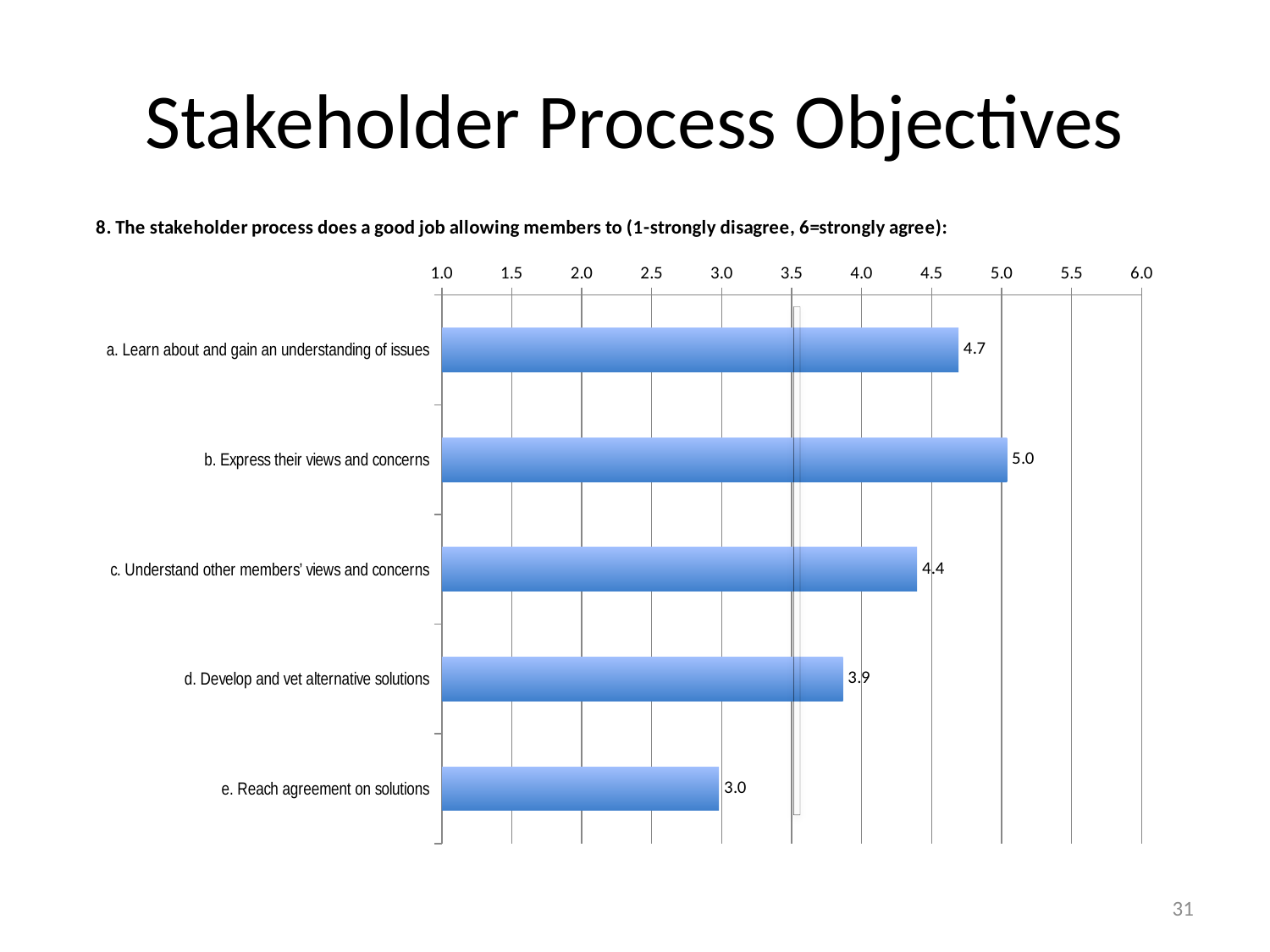
Is the value for "d. Develop and vet alternative solutions" greater or less than 3.5? greater Which category has the lowest value? e. Reach agreement on solutions How many categories are shown in the chart? 5 What is the value for "b. Express their views and concerns"? 5.0 What is the maximum value shown on the value axis? 6.0 What is the value for "d. Develop and vet alternative solutions"? 3.9 Which category has the highest value? b. Express their views and concerns What is the difference between the values for "b. Express their views and concerns" and "e. Reach agreement on solutions"? 2.0 Which is larger, the value for "a. Learn about and gain an understanding of issues" or the value for "c. Understand other members' views and concerns"? a. Learn about and gain an understanding of issues What kind of chart is shown on the slide? bar chart What is the value for "c. Understand other members' views and concerns"? 4.4 What is the value for "e. Reach agreement on solutions"? 3.0